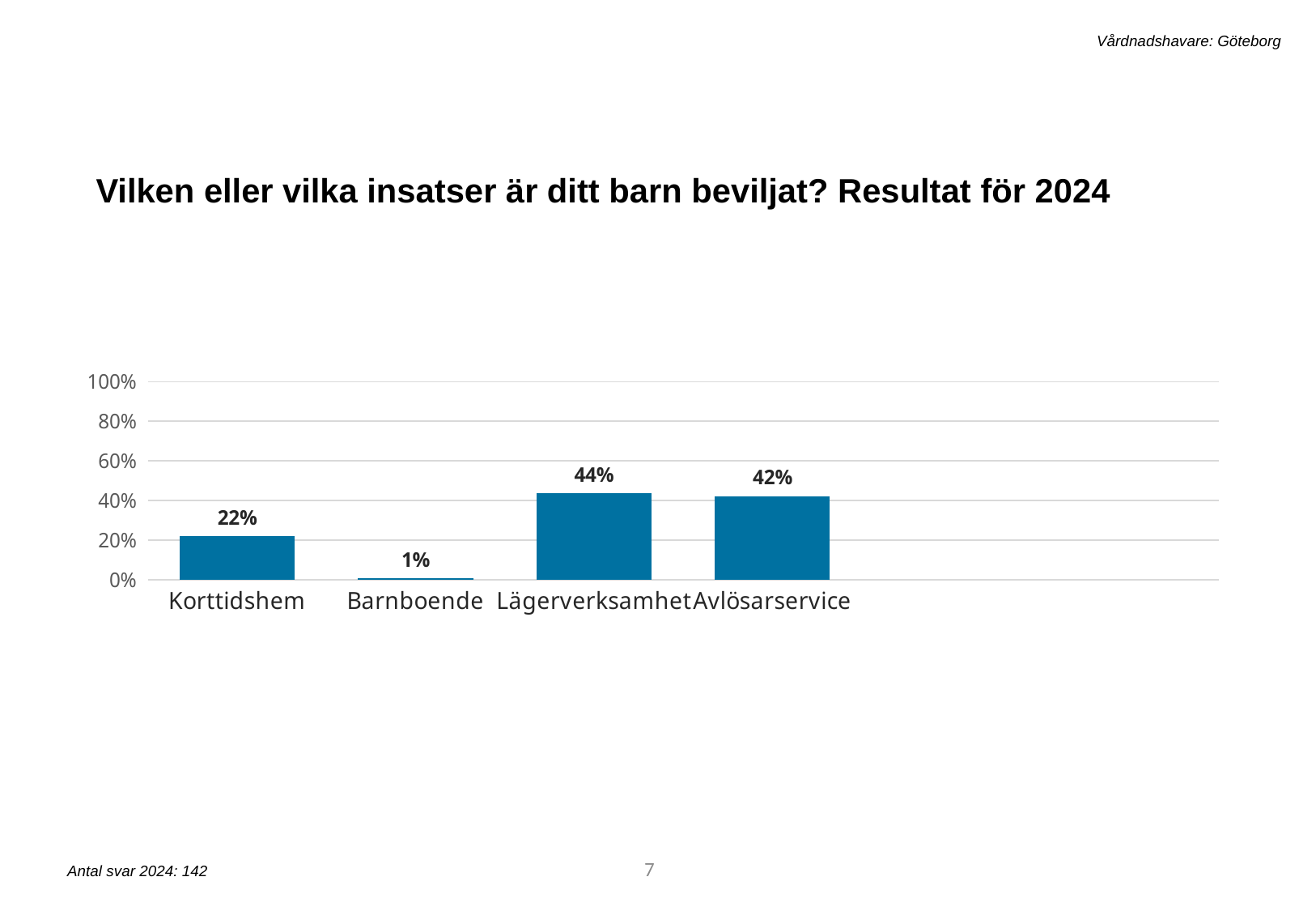
Which category has the highest value? Lägerverksamhet What kind of chart is shown on the slide? Bar chart What is the difference between the values for Korttidshem and Barnboende? 21% What is the value for Barnboende? 1% Which is larger, the value for Korttidshem or the value for Avlösarservice? Avlösarservice What is the value for Avlösarservice? 42% What is the value for Korttidshem? 22% What is the difference between the values for Lägerverksamhet and Avlösarservice? 2% What is the value for Lägerverksamhet? 44% Which category has the lowest value? Barnboende Is the value for Lägerverksamhet greater or less than 40%? greater How many categories are shown in the chart? 4